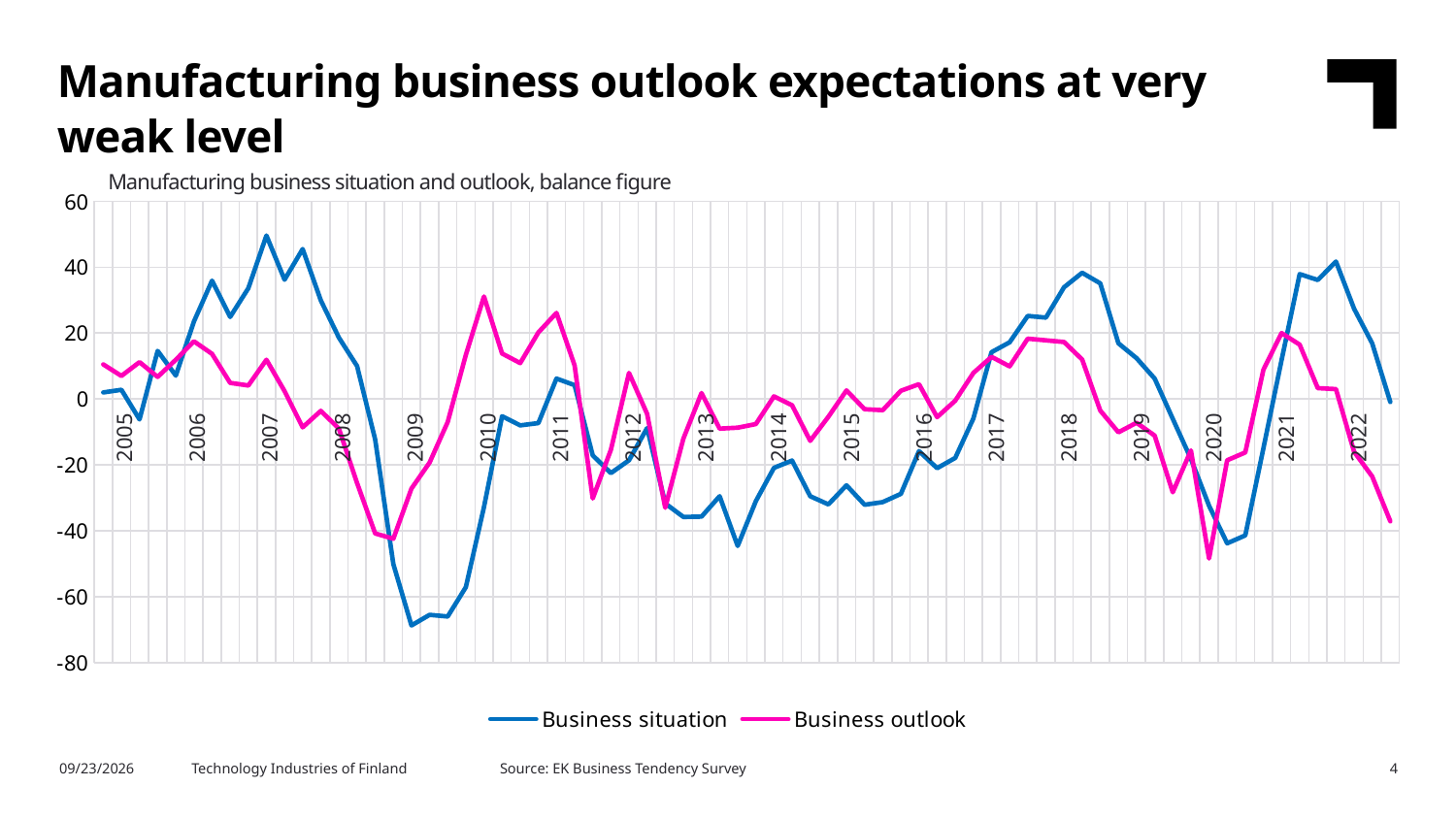
Is the peak of the Business situation line in 2007 greater or less than 40? greater Is the lowest value of the Business situation line, reached around 2009, greater or less than -60? less What is the chart's title (the subtitle above the plot area)? Manufacturing business situation and outlook, balance figure Which series reaches the highest value anywhere on the chart? Business situation Does the Business outlook line rise or fall over the course of 2022? Fall Is the lowest value of the Business outlook line, reached around 2020, greater or less than -40? less How many year labels are shown on the x axis? 18 Which series reaches the lowest value anywhere on the chart? Business situation What are the two series named in the legend? Business situation and Business outlook What kind of chart is shown on the slide? Line chart How many series does the legend list? 2